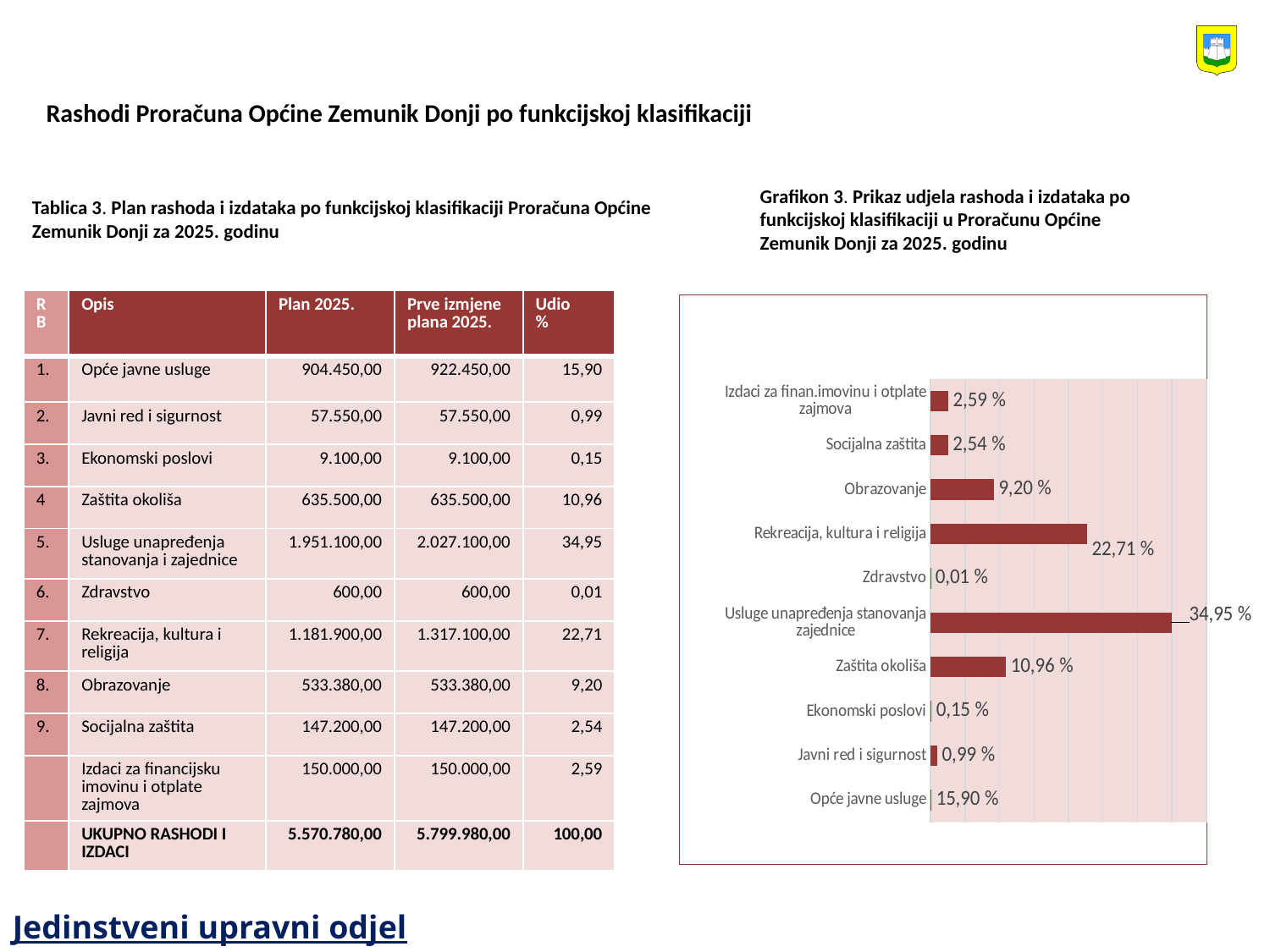
What is the difference between the values for Zaštita okoliša and Javni red i sigurnost in the bar chart? 9,97 % What kind of chart is shown on the slide? bar chart What is the title of the chart on the slide? Grafikon 3. Prikaz udjela rashoda i izdataka po funkcijskoj klasifikaciji u Proračunu Općine Zemunik Donji za 2025. godinu What is the value shown for Zaštita okoliša in the bar chart? 10,96 % What is the value shown for Obrazovanje in the bar chart? 9,20 % How many categories does the bar chart show? 10 What is the difference between the values for Rekreacija, kultura i religija and Obrazovanje in the bar chart? 13,51 % Which category has the highest value in the bar chart? Usluge unapređenja stanovanja zajednice Which is larger in the bar chart, the value for Izdaci za finan.imovinu i otplate zajmova or the value for Socijalna zaštita? Izdaci za finan.imovinu i otplate zajmova What is the value shown for Socijalna zaštita in the bar chart? 2,54 % What is the value shown for Rekreacija, kultura i religija in the bar chart? 22,71 % Which category has the lowest value in the bar chart? Zdravstvo